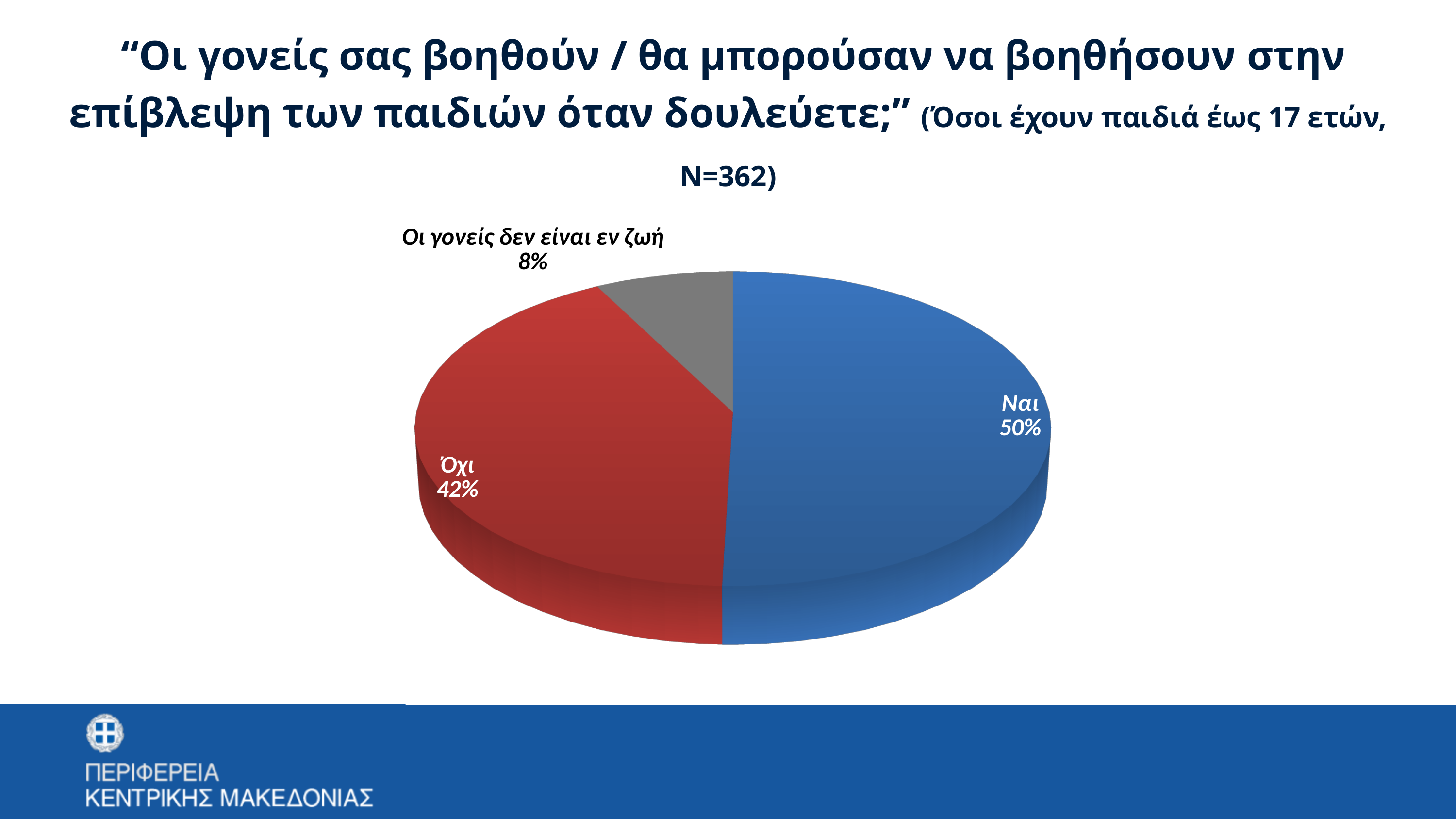
How many slices does the pie chart have? 3 Which is larger, the share for "Όχι" or the share for "Οι γονείς δεν είναι εν ζωή"? Όχι What is the difference in percentage points between "Ναι" and "Όχι"? 8 What is the sample size (N) stated in the chart title? 362 What colour is the "Ναι" slice? Blue What percentage of respondents answered "Ναι"? 50% Which category has the smallest share of the pie? Οι γονείς δεν είναι εν ζωή What share of the pie is labelled "Οι γονείς δεν είναι εν ζωή"? 8% What kind of chart is shown on the slide? Pie chart What percentage of respondents answered "Όχι"? 42% Which category has the largest share of the pie? Ναι